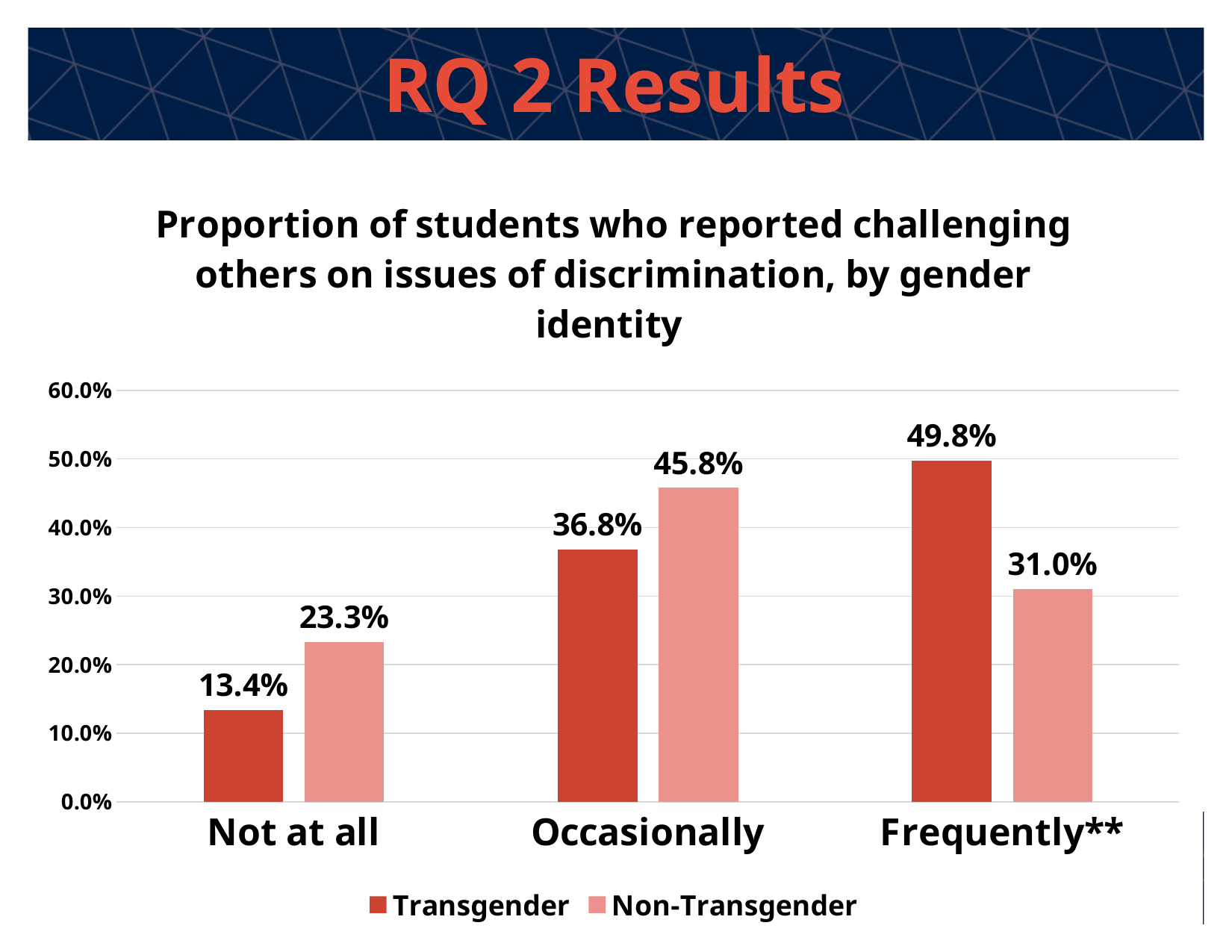
Do the Transgender values rise or fall from 'Not at all' to 'Frequently**'? Rise What is the value for Non-Transgender students in the 'Occasionally' category? 45.8% How many series does the legend list? 2 How many categories are shown on the x axis? 3 What is the difference between the Transgender and Non-Transgender values in the 'Frequently**' category? 18.8% In the 'Occasionally' category, which group has the larger value, Transgender or Non-Transgender? Non-Transgender Which category has the highest value for Transgender students? Frequently** What is the difference between the Non-Transgender and Transgender values in the 'Not at all' category? 9.9% What percentage of Transgender students reported challenging others on discrimination 'Not at all'? 13.4% Which category has the lowest value for Non-Transgender students? Not at all What kind of chart is shown on the slide? Bar chart What is the value for Transgender students in the 'Frequently**' category? 49.8%